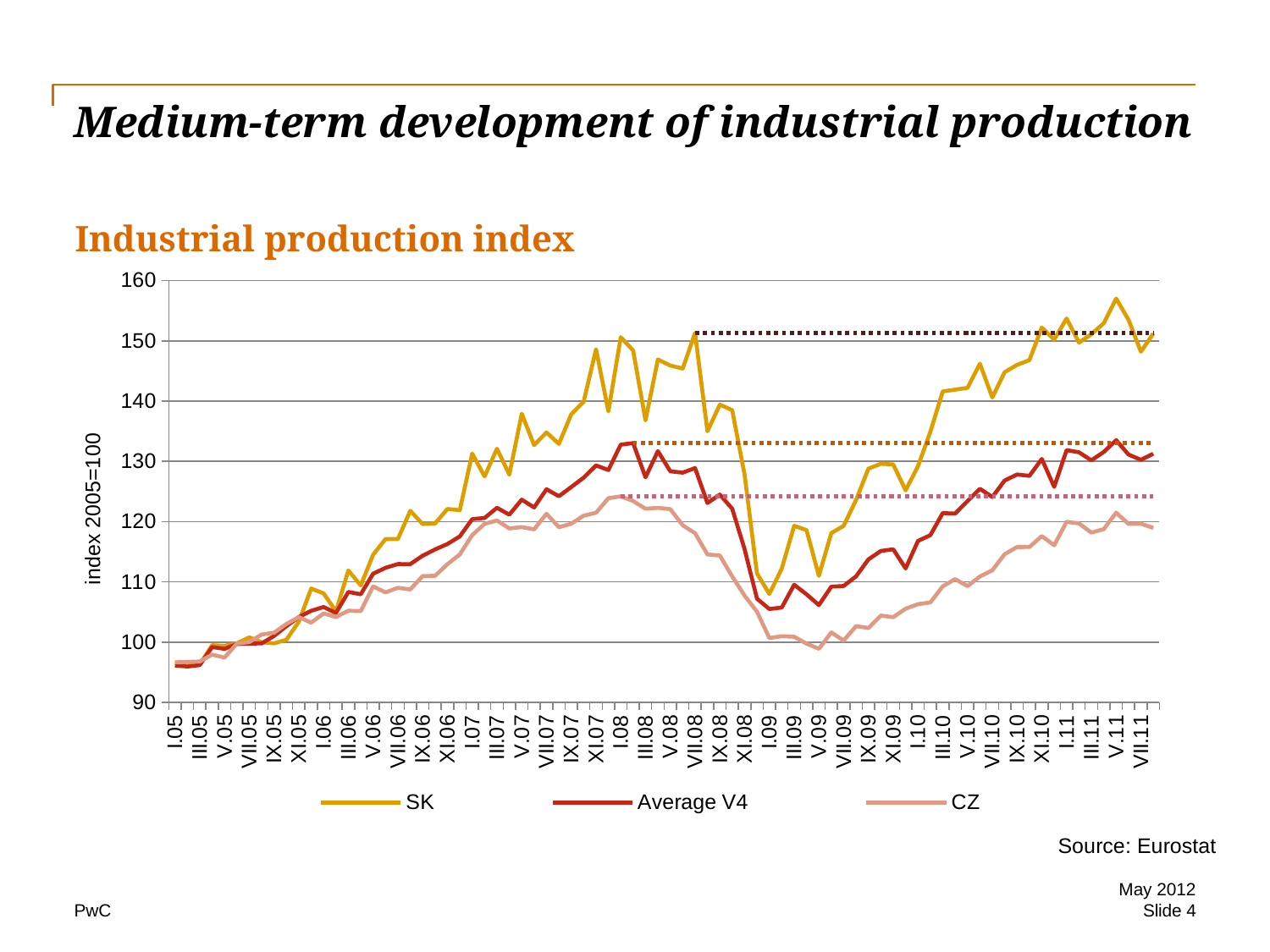
Is the value for CZ at V.09 greater or less than 100? less How many series does the legend list? 3 Do the values for SK rise or fall between VII.08 and I.09? fall At V.11, which series has the higher value, SK or CZ? SK What kind of chart is shown on the slide? line chart Is the value for Average V4 at I.09 greater or less than 110? less Is the value for SK at V.11 greater or less than 150? greater What are the three series named in the legend? SK, Average V4, CZ Which series has the highest value at VII.11? SK What is the label on the vertical axis? index 2005=100